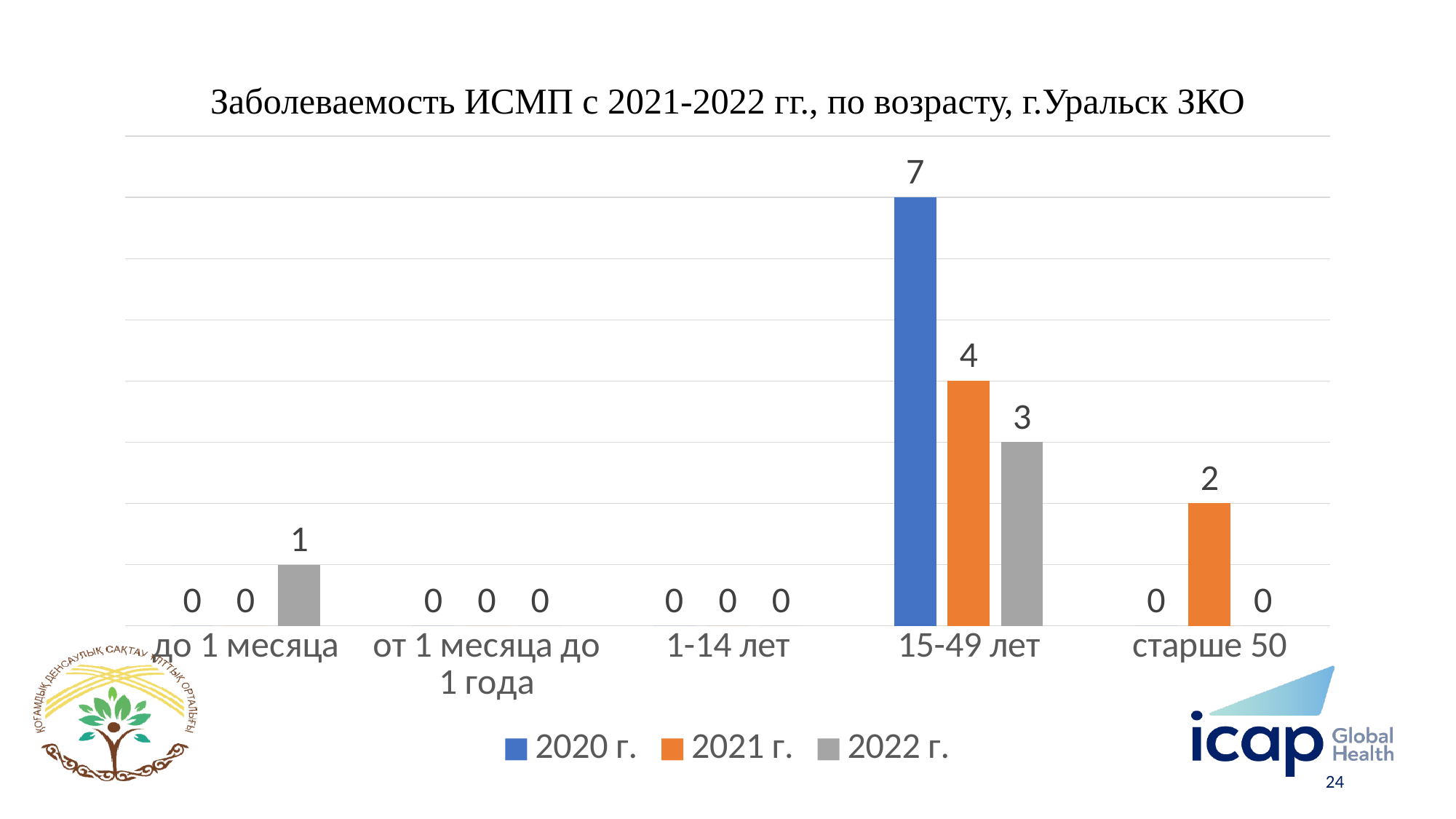
Which colour represents 2021 г. in the legend? Orange What is the value for 2021 г. in the старше 50 category? 2 How many age categories are shown on the x axis? 5 What is the value for 2022 г. in the 15-49 лет category? 3 What kind of chart is shown on the slide? Bar chart Which is larger in the 15-49 лет category: the value for 2021 г. or for 2022 г.? 2021 г. How many series does the legend list? 3 What is the value for 2020 г. in the 15-49 лет category? 7 What is the difference between the 2020 г. and 2021 г. values in the 15-49 лет category? 3 Do the values for 15-49 лет rise or fall from 2020 г. to 2022 г.? Fall What is the value for 2022 г. in the до 1 месяца category? 1 Which age category has the highest value for 2021 г.? 15-49 лет